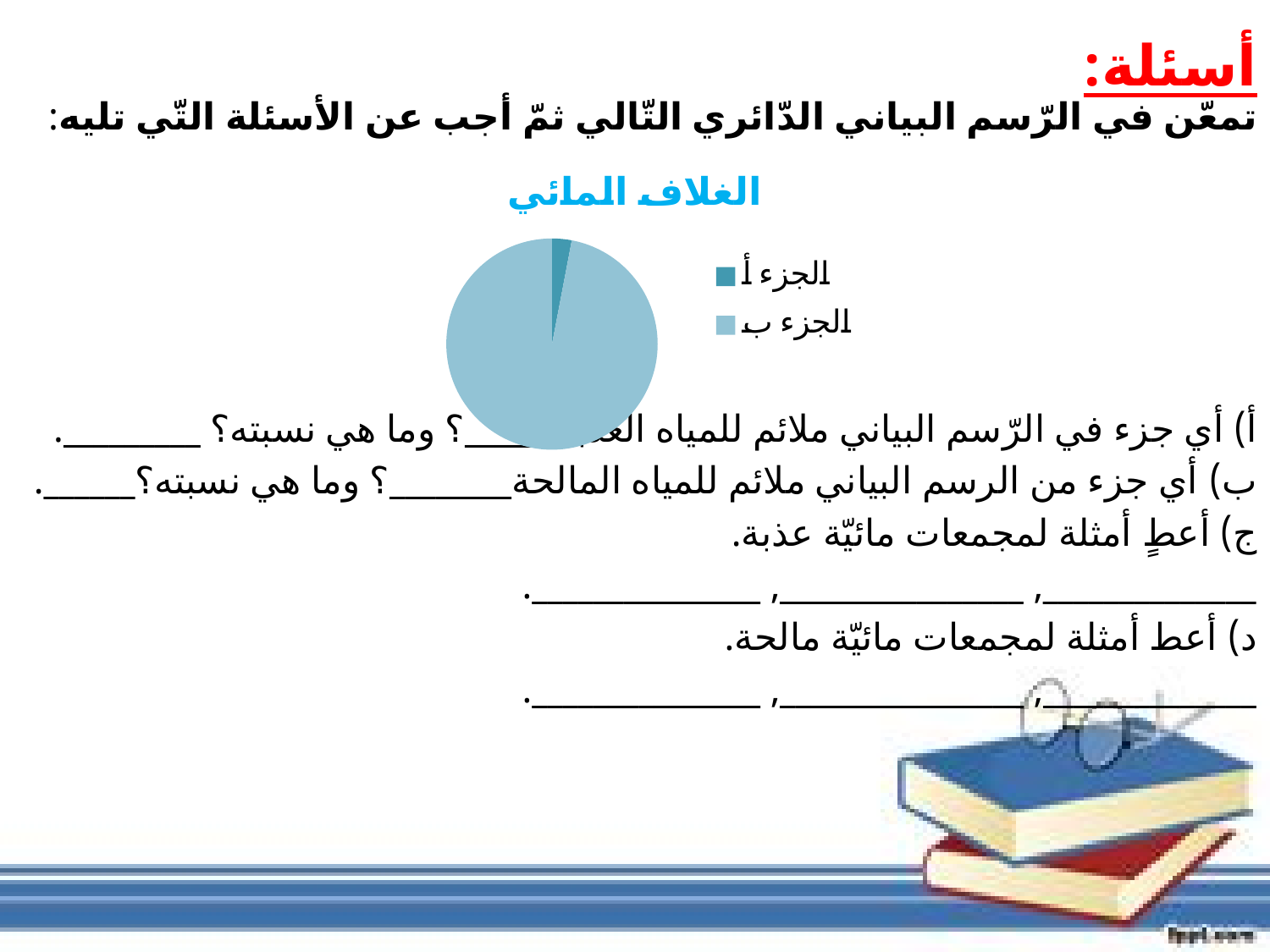
How many entries does the legend of the pie chart list? 2 What are the two legend entries of the pie chart? الجزء أ, الجزء ب What kind of chart is shown on the slide? pie chart Which slice of the pie chart is the largest? الجزء ب Which slice of the pie chart is the smallest? الجزء أ How many slices does the pie chart have? 2 Which is larger in the pie chart, الجزء أ or الجزء ب? الجزء ب What is the title of the pie chart? الغلاف المائي